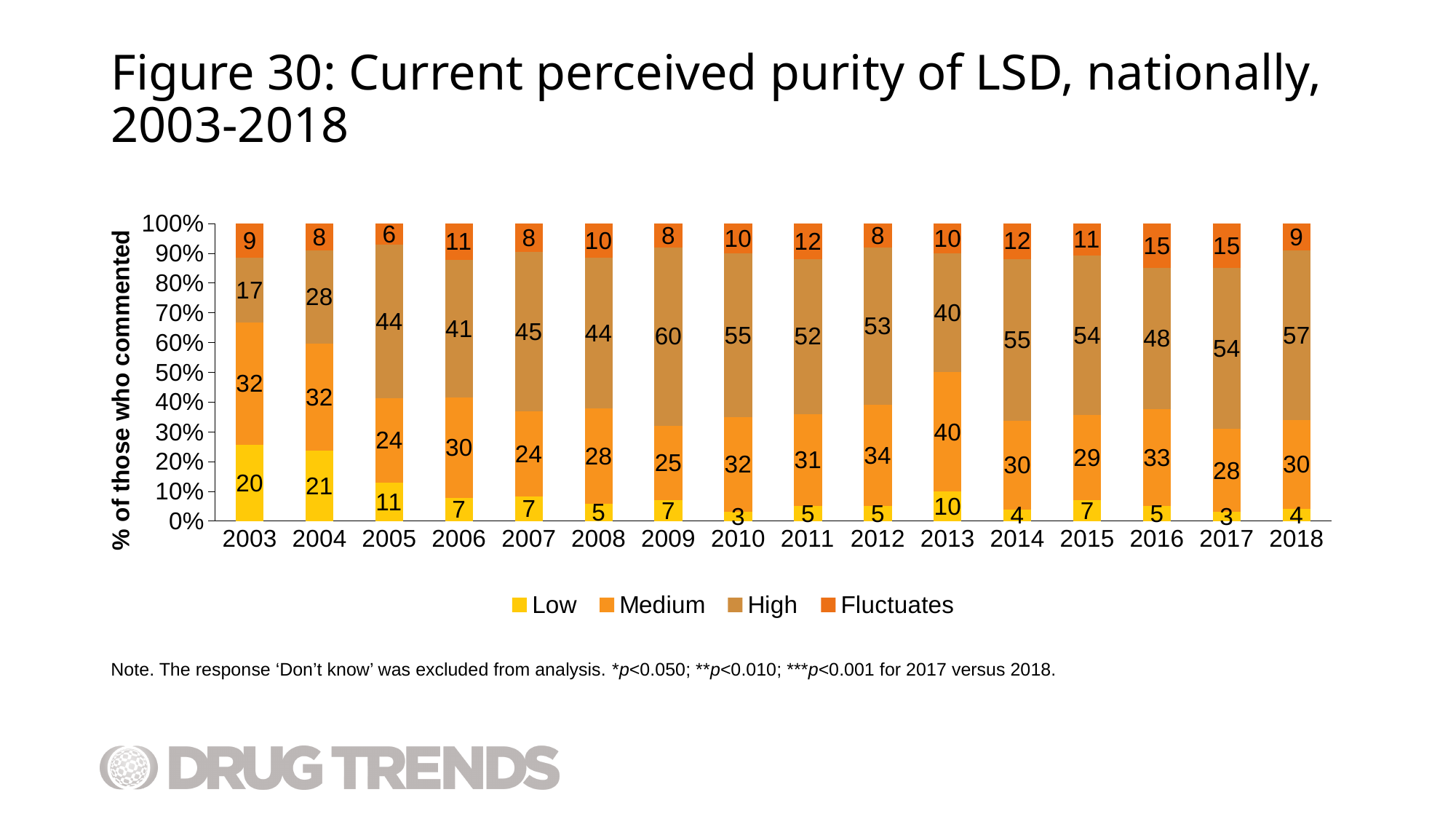
How many series does the legend list? 4 What is the value for Low in 2003? 20 In which year is the High value the largest? 2009 How many years are shown on the x axis? 16 What is the difference between the High values for 2018 and 2017? 3 Which is larger, the Medium value in 2012 or the Medium value in 2014? 2012 What is the value for Fluctuates in 2016? 15 What is the value for Medium in 2013? 40 In which year is the Fluctuates value the smallest? 2005 In which year is the High value the smallest? 2003 What is the value for High in 2009? 60 What kind of chart is shown on the slide? Stacked bar chart